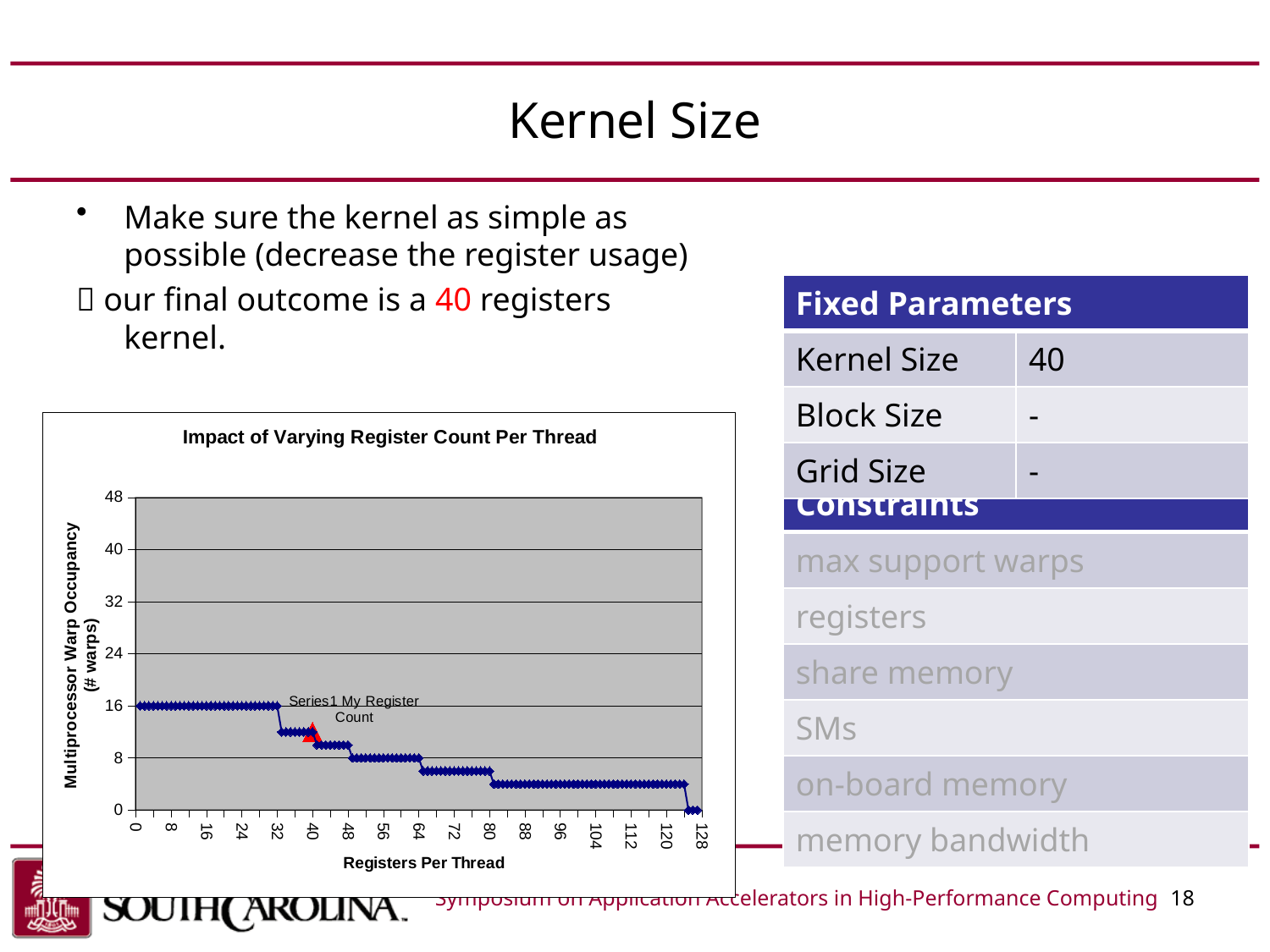
What is the label of the x axis of the chart? Registers Per Thread Does the multiprocessor warp occupancy rise or fall as registers per thread increase? fall What is the difference in warp occupancy between 8 registers per thread and 56 registers per thread? 8 Is the warp occupancy at 16 registers per thread greater or less than 8? greater Which has the larger warp occupancy: 16 registers per thread or 96 registers per thread? 16 registers per thread What is the multiprocessor warp occupancy at 8 registers per thread? 16 Is the warp occupancy at 100 registers per thread greater or less than 8? less What is the multiprocessor warp occupancy at 128 registers per thread? 0 What is the title of the chart? Impact of Varying Register Count Per Thread What is the multiprocessor warp occupancy at 56 registers per thread? 8 What kind of chart is shown on the slide? line chart